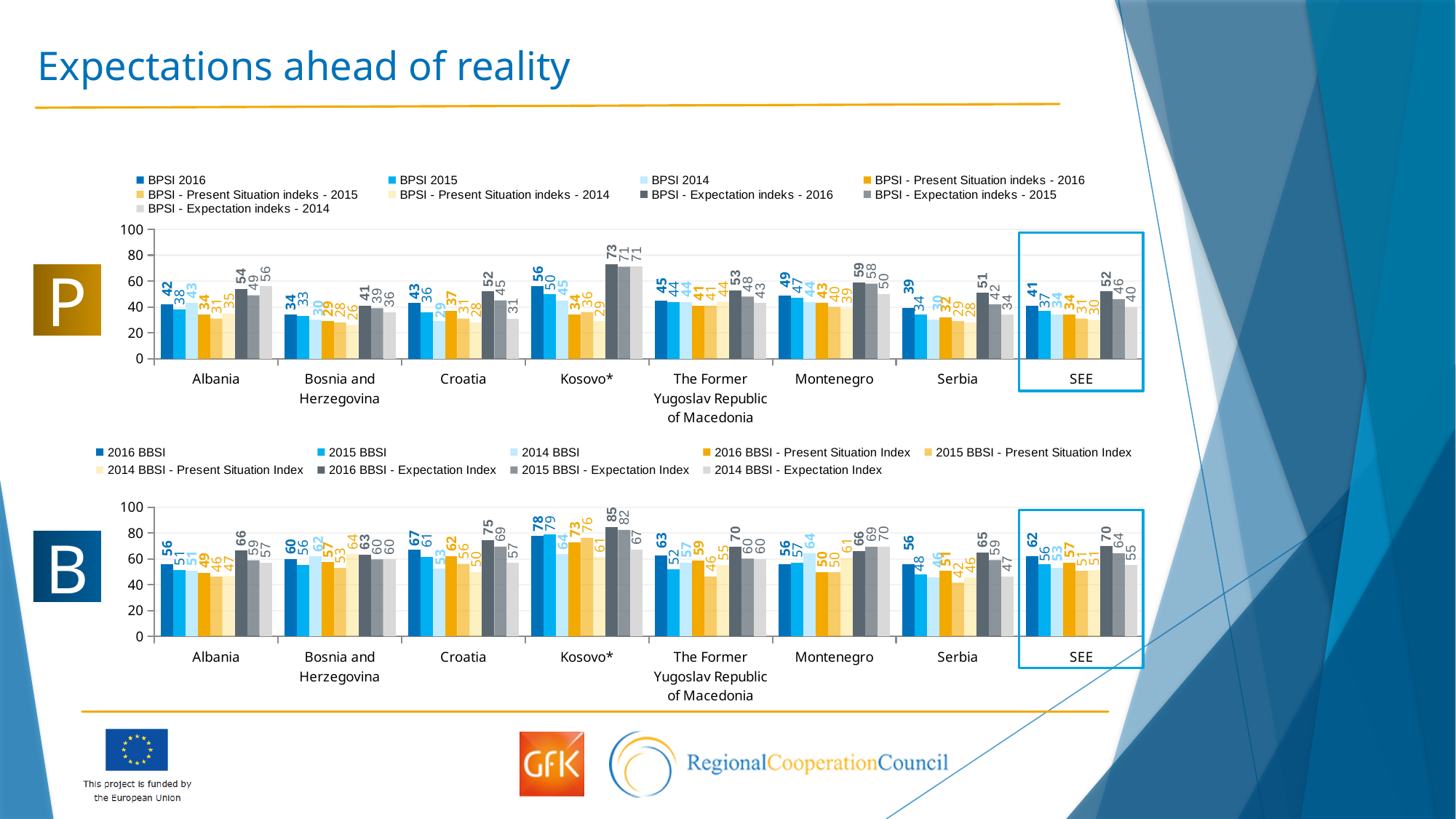
In the bottom chart, which is larger for Montenegro: the 2016 BBSI value or the 2014 BBSI value? 2014 BBSI In the bottom chart, what is the 2016 BBSI - Expectation Index value for Kosovo*? 85 In the top chart, what is the difference between the BPSI - Expectation indeks - 2016 and the BPSI - Present Situation indeks - 2016 values for Albania? 20 In the bottom chart, what is the difference between the 2016 BBSI values for Kosovo* and Serbia? 22 In the top chart, which country has the highest BPSI 2016 value? Kosovo* In the bottom chart, what is the 2016 BBSI value for Croatia? 67 How many series does the legend of the top chart list? 9 How many categories are shown on the x axis of the bottom chart? 8 In the bottom chart, which category has the lowest 2016 BBSI - Present Situation Index value? Albania What type of chart is the bottom chart? Bar chart In the top chart, what is the BPSI 2016 value for Kosovo*? 56 In the top chart, what is the BPSI - Expectation indeks - 2016 value for SEE? 52